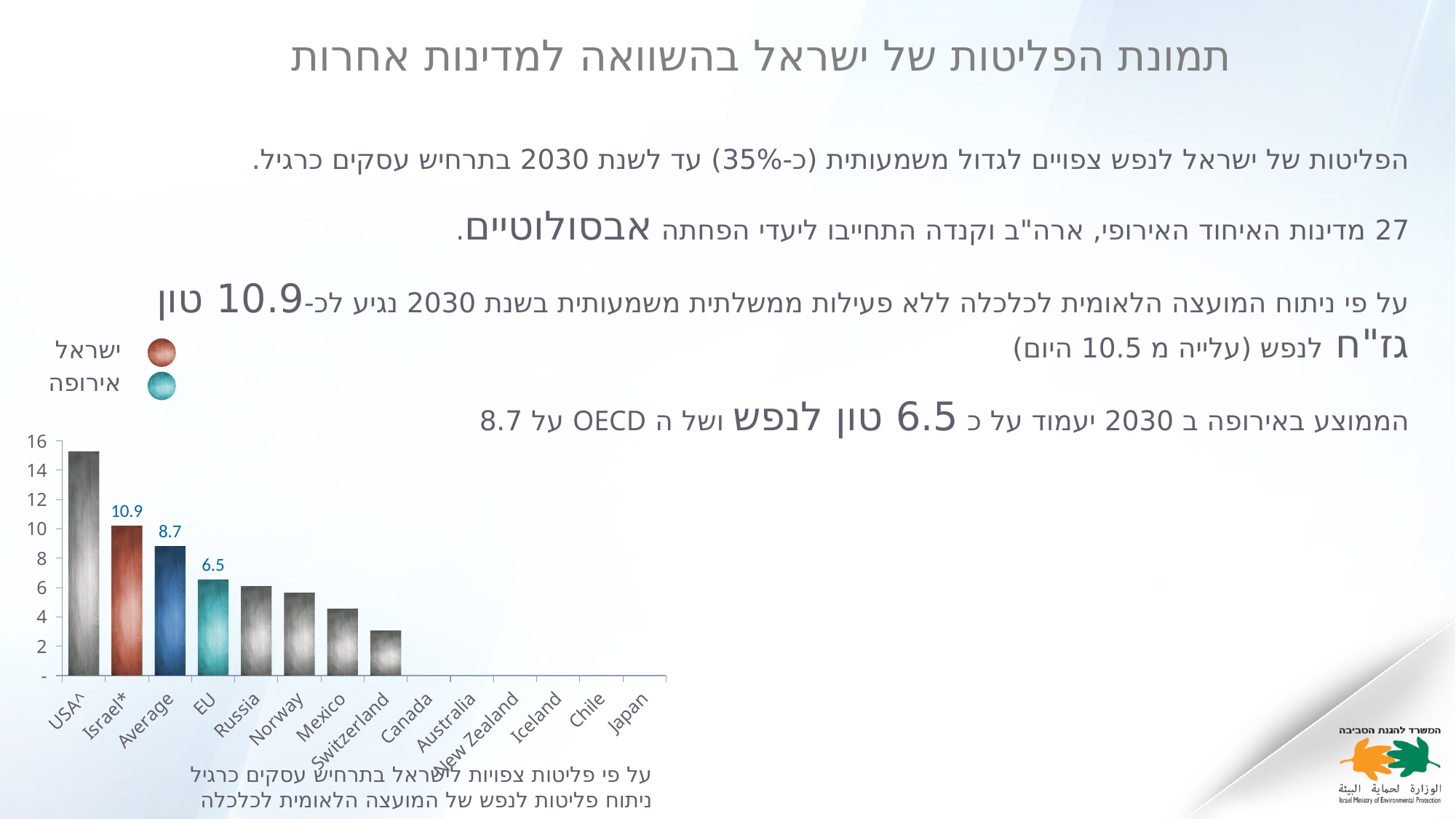
Is the value for Russia greater or less than 8? less Is the value for USA^ greater or less than 14? greater What is the difference between the values for Israel* and Average? 2.2 Which category has the tallest bar in the chart? USA^ What is the value for Average in the bar chart? 8.7 What is the value for Israel* in the bar chart? 10.9 What kind of chart is shown on the slide? bar chart How many category labels are shown on the x axis of the chart? 14 What is the difference between the values for Israel* and EU? 4.4 Which is larger, the value for Israel* or the value for Average? Israel* Is the value for Switzerland greater or less than 4? less What is the value for EU in the bar chart? 6.5